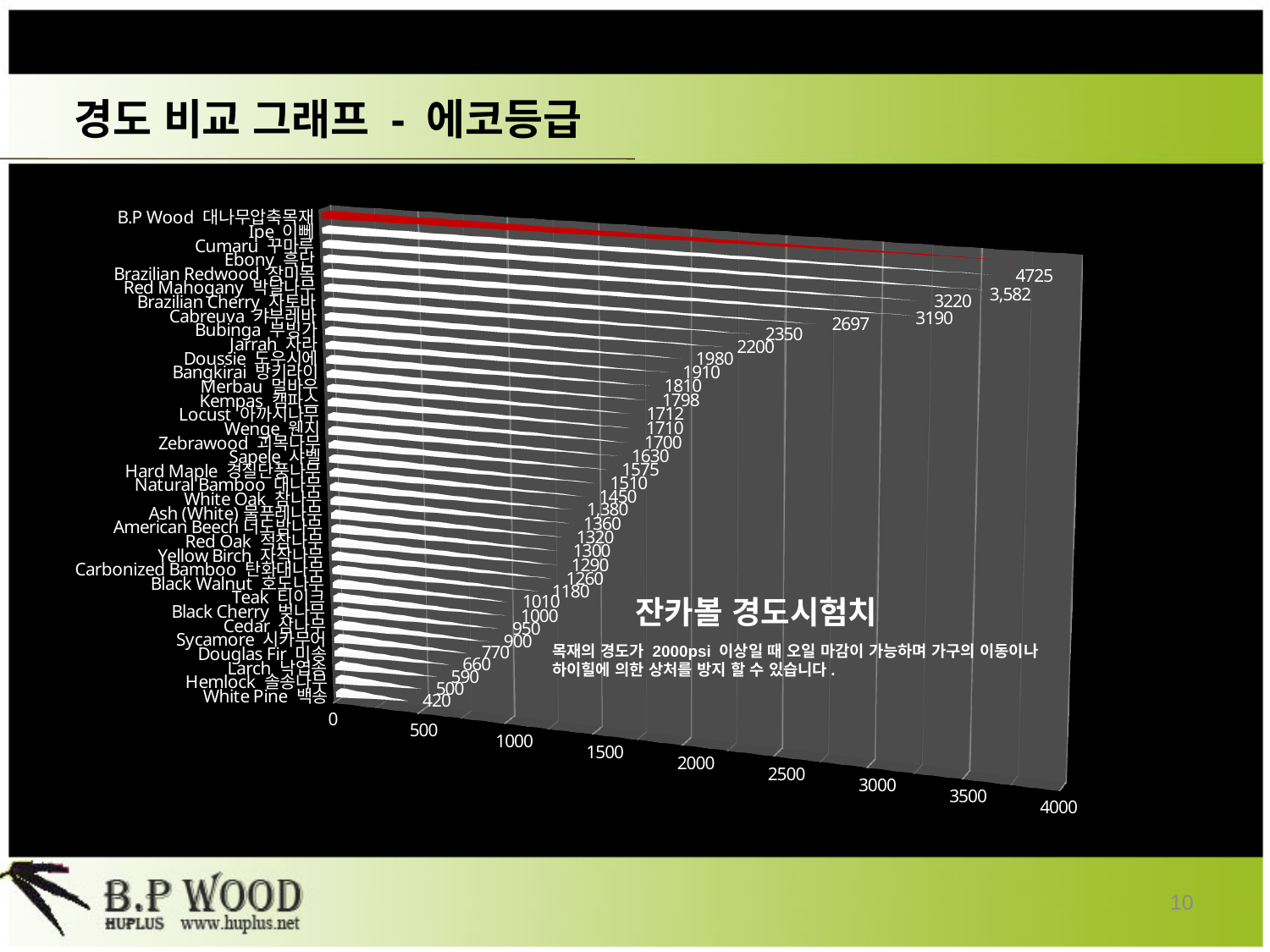
Which category has the lowest hardness value in the chart? White Pine 백송 Which has a larger hardness value, B.P Wood 대나무압축목재 or Ipe 이뻬? B.P Wood 대나무압축목재 Is the value for Ipe 이뻬 greater or less than 3000? greater Which category has the highest hardness value in the chart? B.P Wood 대나무압축목재 What is the hardness value shown for B.P Wood 대나무압축목재? 4725 Do the bar values increase or decrease going from the top category to the bottom category? decrease What is the hardness value shown for White Pine 백송? 420 How many wood categories are listed in the chart? 35 Which has a larger hardness value, Ebony 흑단 or Teak 티크? Ebony 흑단 What is the highest tick value shown on the horizontal axis? 4000 What kind of chart is shown on the slide? bar chart Is the value for Hemlock 솔송나무 greater or less than 1000? less